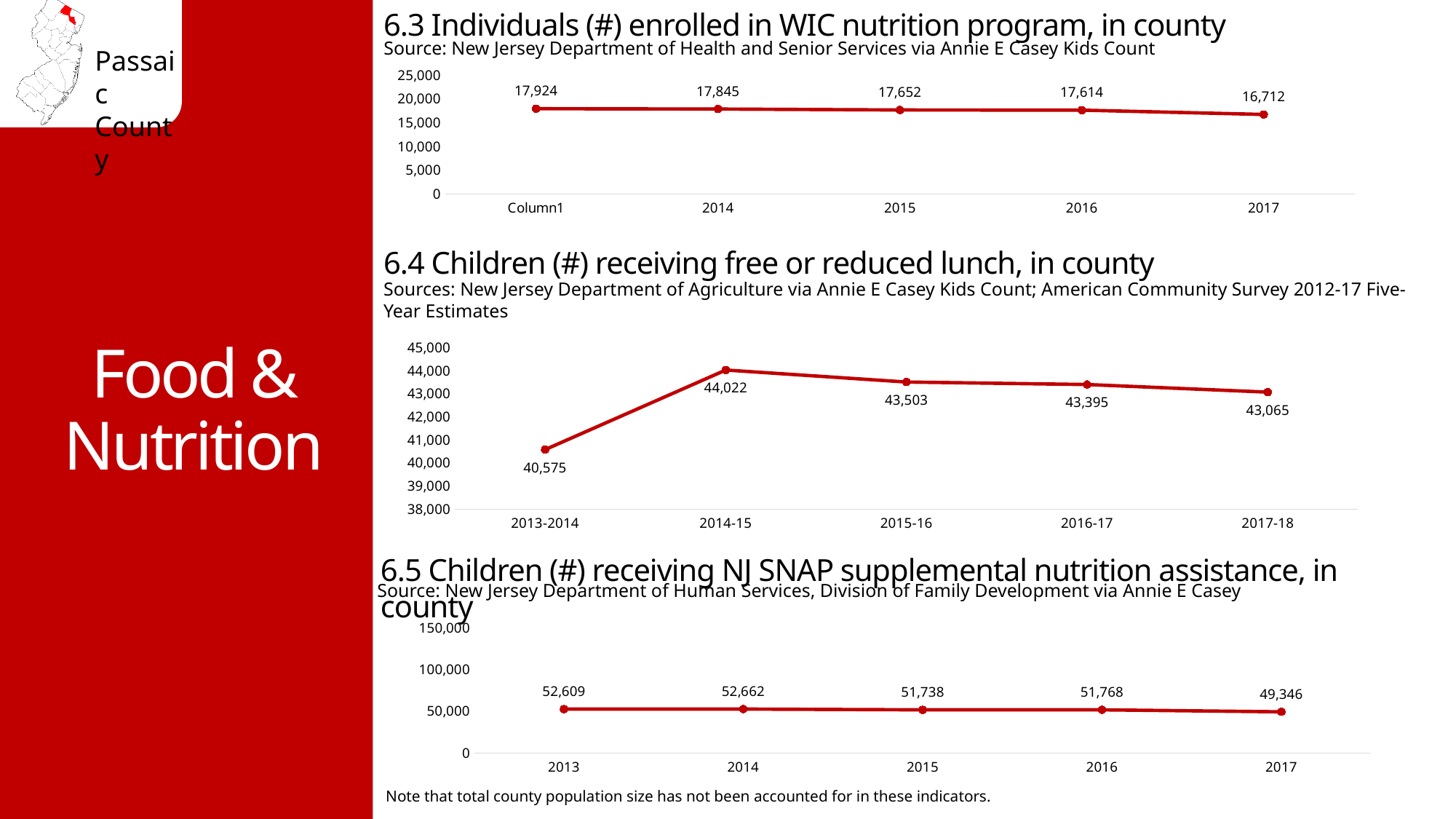
In the chart '6.4 Children (#) receiving free or reduced lunch, in county', how many data points are plotted? 5 In the chart '6.4 Children (#) receiving free or reduced lunch, in county', which school year has the highest value? 2014-15 In the chart '6.5 Children (#) receiving NJ SNAP supplemental nutrition assistance, in county', what is the value for 2014? 52,662 In the chart '6.3 Individuals (#) enrolled in WIC nutrition program, in county', what is the value for 2015? 17,652 In the chart '6.4 Children (#) receiving free or reduced lunch, in county', which school year has the lowest value? 2013-2014 What type of chart is '6.5 Children (#) receiving NJ SNAP supplemental nutrition assistance, in county'? line chart In the chart '6.3 Individuals (#) enrolled in WIC nutrition program, in county', what is the difference between the 2016 value and the 2017 value? 902 In the chart '6.3 Individuals (#) enrolled in WIC nutrition program, in county', what is the value for 2017? 16,712 In the chart '6.5 Children (#) receiving NJ SNAP supplemental nutrition assistance, in county', which is larger, the value for 2013 or the value for 2017? 2013 In the chart '6.4 Children (#) receiving free or reduced lunch, in county', what is the value for 2016-17? 43,395 In the chart '6.4 Children (#) receiving free or reduced lunch, in county', what is the difference between the 2014-15 value and the 2013-2014 value? 3,447 In the chart '6.3 Individuals (#) enrolled in WIC nutrition program, in county', do the values rise or fall from left to right along the x axis? fall